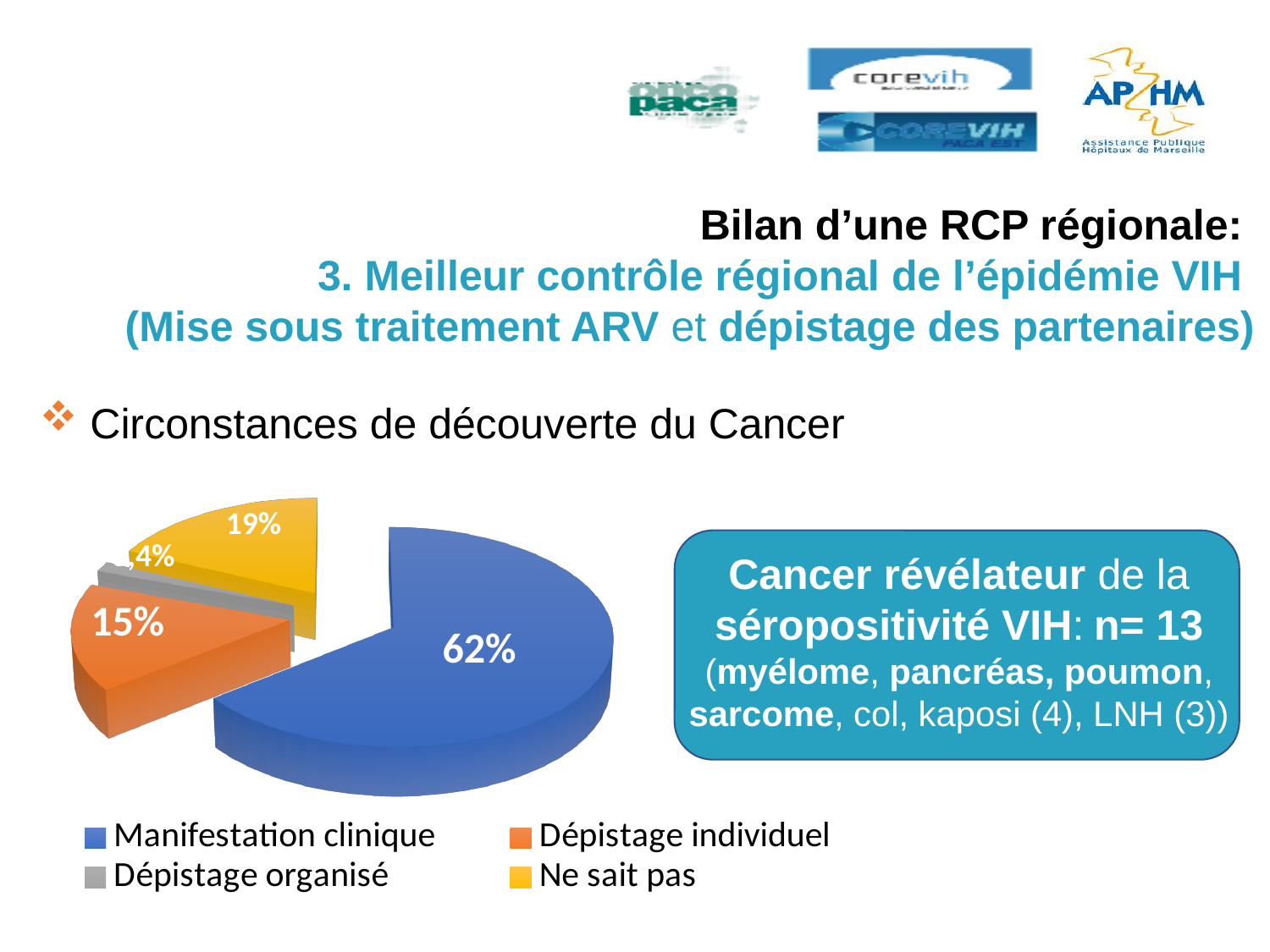
What kind of chart is shown on the slide? pie chart What share of the pie does "Ne sait pas" represent? 19% Which colour represents "Ne sait pas" in the pie chart? yellow Which is larger: the share of "Ne sait pas" or the share of "Dépistage individuel"? Ne sait pas Which category has the smallest slice of the pie? Dépistage organisé How many slices does the pie chart have? 4 What share of the pie does "Manifestation clinique" represent? 62% What is the difference between the shares of "Manifestation clinique" and "Ne sait pas"? 43% What share of the pie does "Dépistage individuel" represent? 15% Which category has the largest slice of the pie? Manifestation clinique How many entries does the legend list? 4